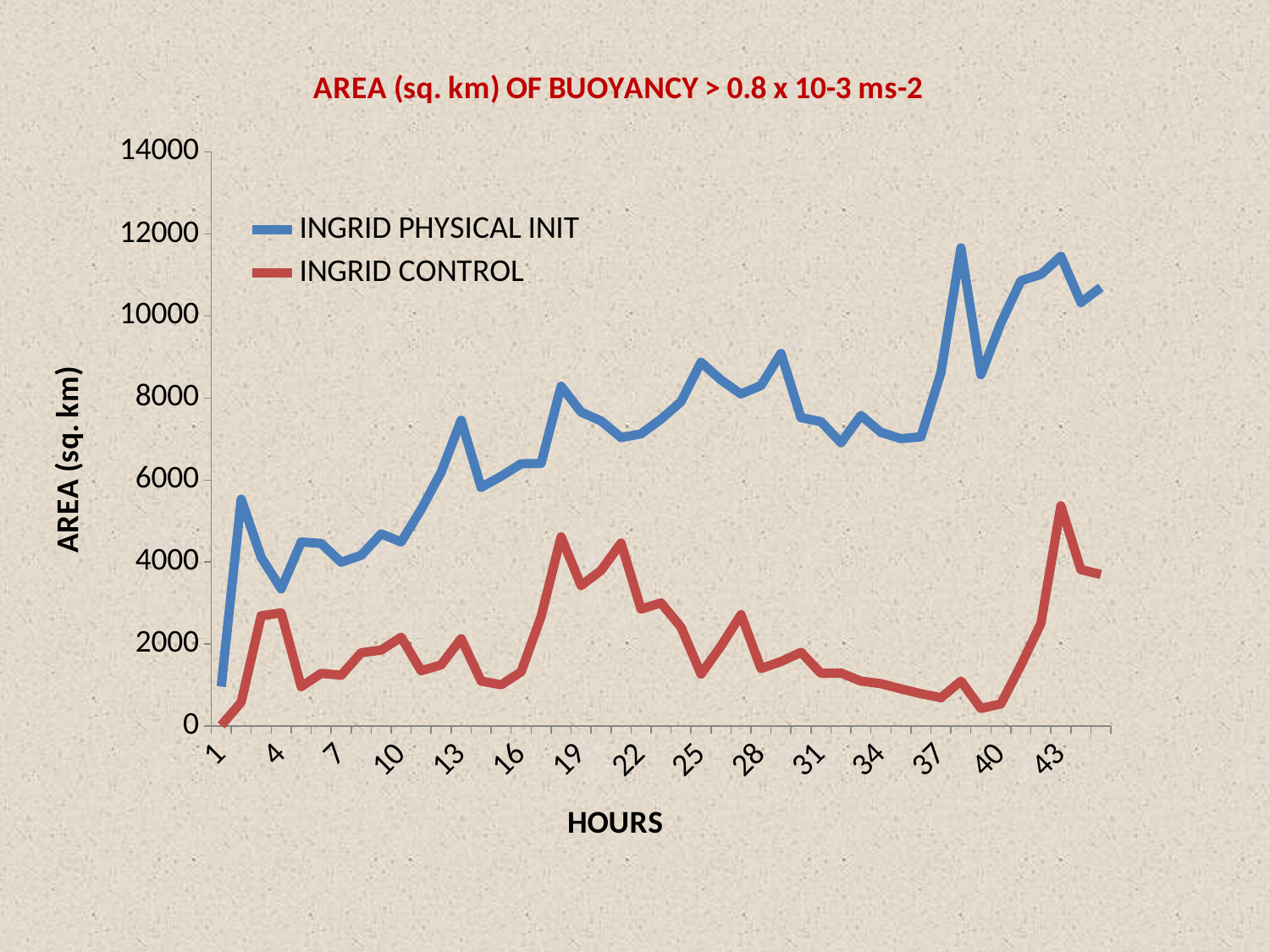
What kind of chart is shown on the slide? line chart Is the value for INGRID CONTROL at hour 19 greater or less than 4000? less Is the value for INGRID CONTROL at hour 40 greater or less than 2000? less What are the two series named in the legend? INGRID PHYSICAL INIT and INGRID CONTROL At hour 19, which series has the larger value, INGRID PHYSICAL INIT or INGRID CONTROL? INGRID PHYSICAL INIT Which series reaches the highest value on the chart? INGRID PHYSICAL INIT Is the value for INGRID PHYSICAL INIT at hour 1 greater or less than 2000? less What is the title of the y axis? AREA (sq. km) Does the INGRID PHYSICAL INIT series generally rise or fall from hour 1 to hour 43? rise How many series does the legend list? 2 Which series has the lower value at hour 43, INGRID PHYSICAL INIT or INGRID CONTROL? INGRID CONTROL